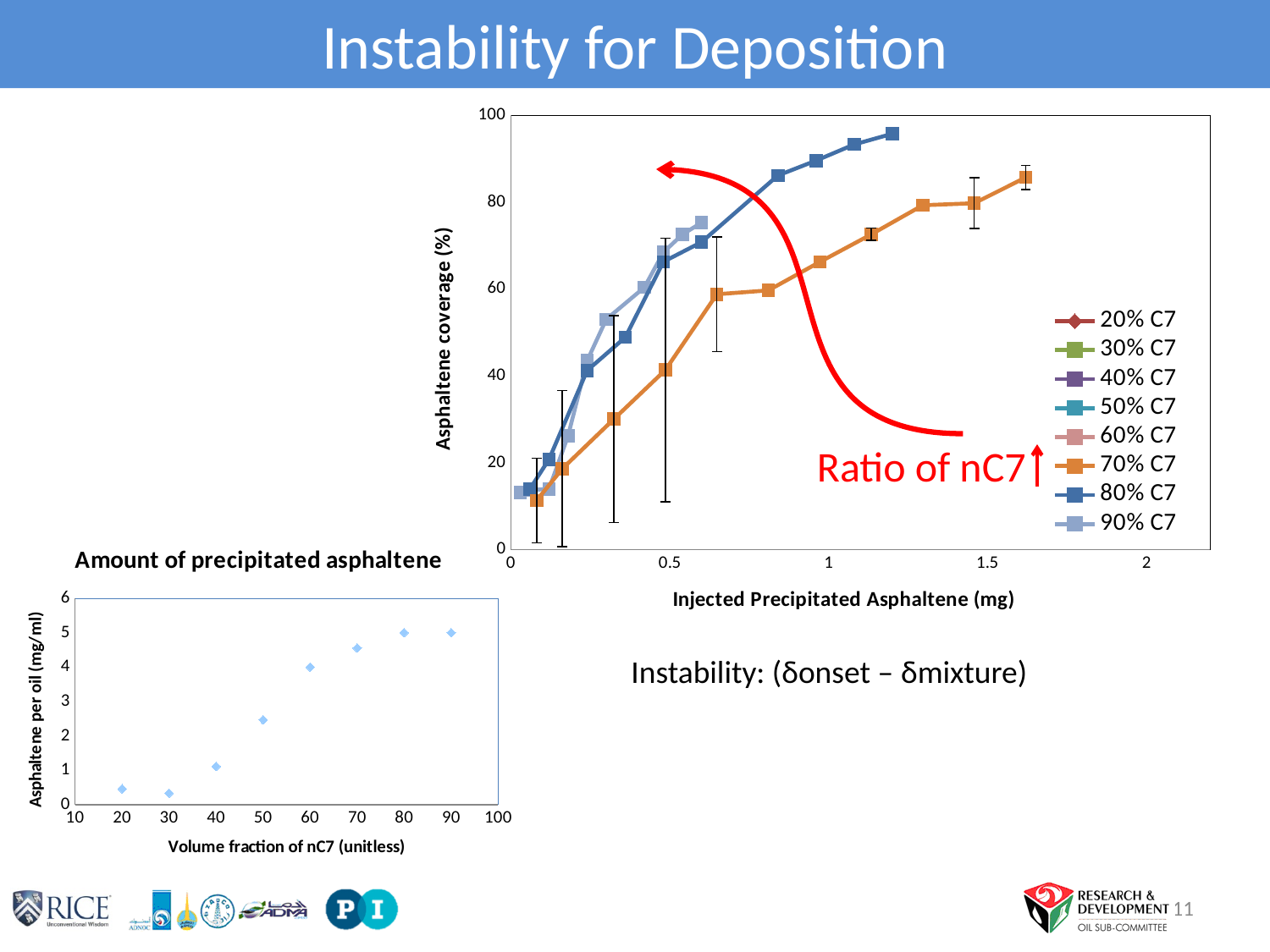
On the large chart on the right, which plotted series reaches the highest asphaltene coverage? 80% C7 On the large chart on the right, at an injected precipitated asphaltene of about 1.1 mg, which series has the larger coverage: 80% C7 or 70% C7? 80% C7 On the chart titled 'Amount of precipitated asphaltene', do the values rise or fall as the volume fraction of nC7 increases? rise On the chart titled 'Amount of precipitated asphaltene', which has the larger value: volume fraction 60 or volume fraction 40? 60 On the chart titled 'Amount of precipitated asphaltene', how many data points are plotted? 8 On the large chart on the right, what is the x-axis label? Injected Precipitated Asphaltene (mg) On the chart titled 'Amount of precipitated asphaltene', is the value at a volume fraction of 40 greater or less than 2? less On the chart titled 'Amount of precipitated asphaltene', is the value at a volume fraction of 50 greater or less than 2? greater On the large chart on the right, how many series does the legend list? 8 On the chart titled 'Amount of precipitated asphaltene', what is the y-axis label? Asphaltene per oil (mg/ml) On the large chart on the right, is the highest value of the 80% C7 series greater or less than 80? greater On the large chart on the right, does asphaltene coverage rise or fall as injected precipitated asphaltene increases? rise